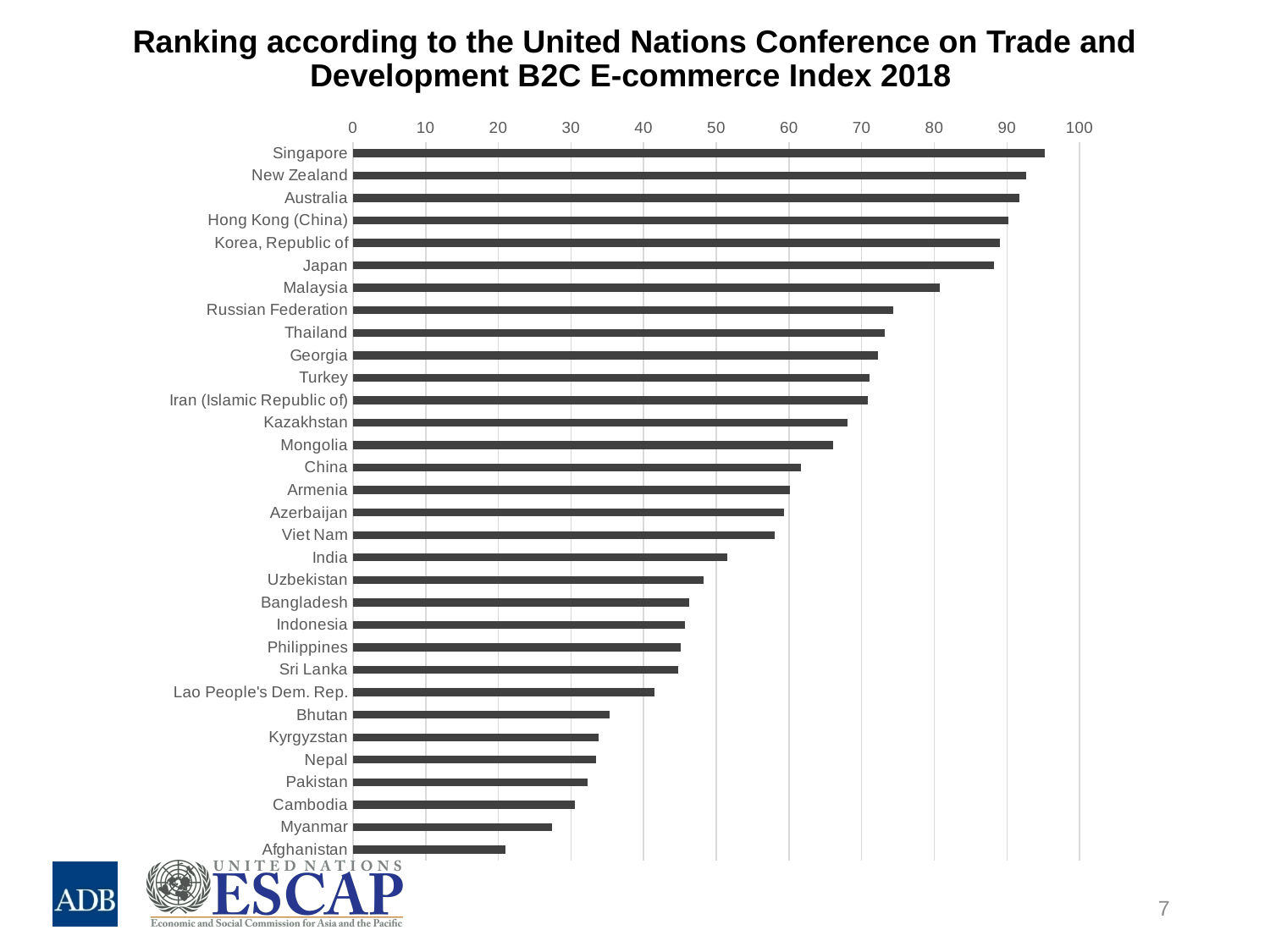
Is the value for Bhutan greater or less than 40? less Is the value for Japan greater or less than 90? less What kind of chart is shown on the slide? Bar chart Which has a larger value, Malaysia or Thailand? Malaysia Which country has the highest value in the chart? Singapore Which has a larger value, India or Pakistan? India Which country has the lowest value in the chart? Afghanistan How many countries are listed in the chart? 32 Is the value for China greater or less than 70? less Do the bar values rise or fall going from the top of the chart to the bottom? Fall